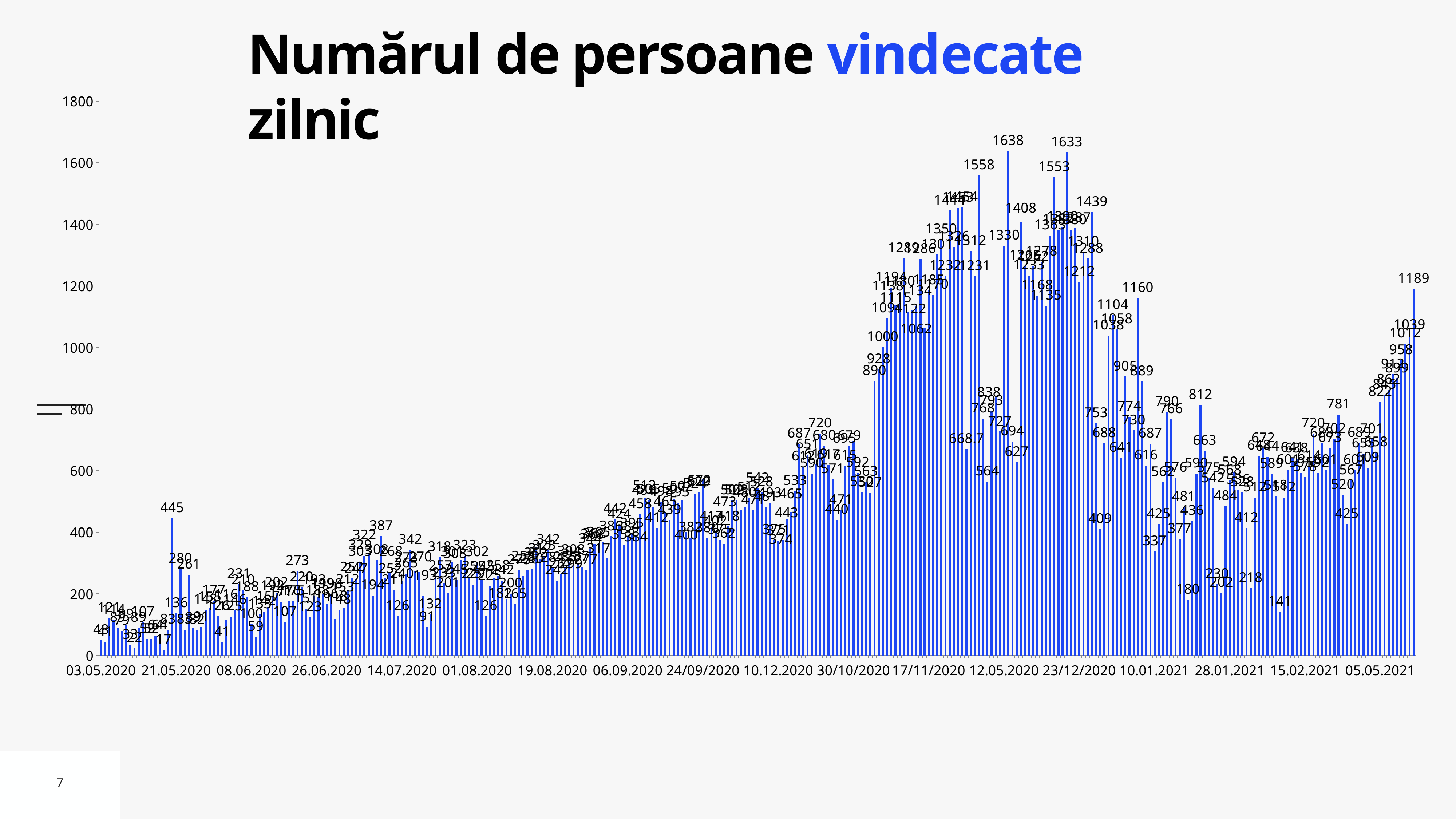
What kind of chart is shown on the slide? bar chart Is the value of the rightmost bar greater or less than 1000? greater What is the maximum value shown on the vertical axis? 1800 What is the highest value labeled among the bars in May 2020 (between 03.05.2020 and 08.06.2020)? 445 Is the value of the first bar on the left (03.05.2020) greater or less than 200? less Which is larger: the highest value in May 2020 (445) or the value of the rightmost bar (1189)? 1189 What is the difference between the highest labeled value (1638) and the value of the rightmost bar (1189)? 449 What is the highest daily value labeled on the chart? 1638 Do the daily values generally rise or fall from May 2020 to November 2020? rise Is the tallest bar on the chart greater or less than 1600? greater What is the title of the chart? Numărul de persoane vindecate zilnic What is the value of the rightmost (last) bar on the chart? 1189